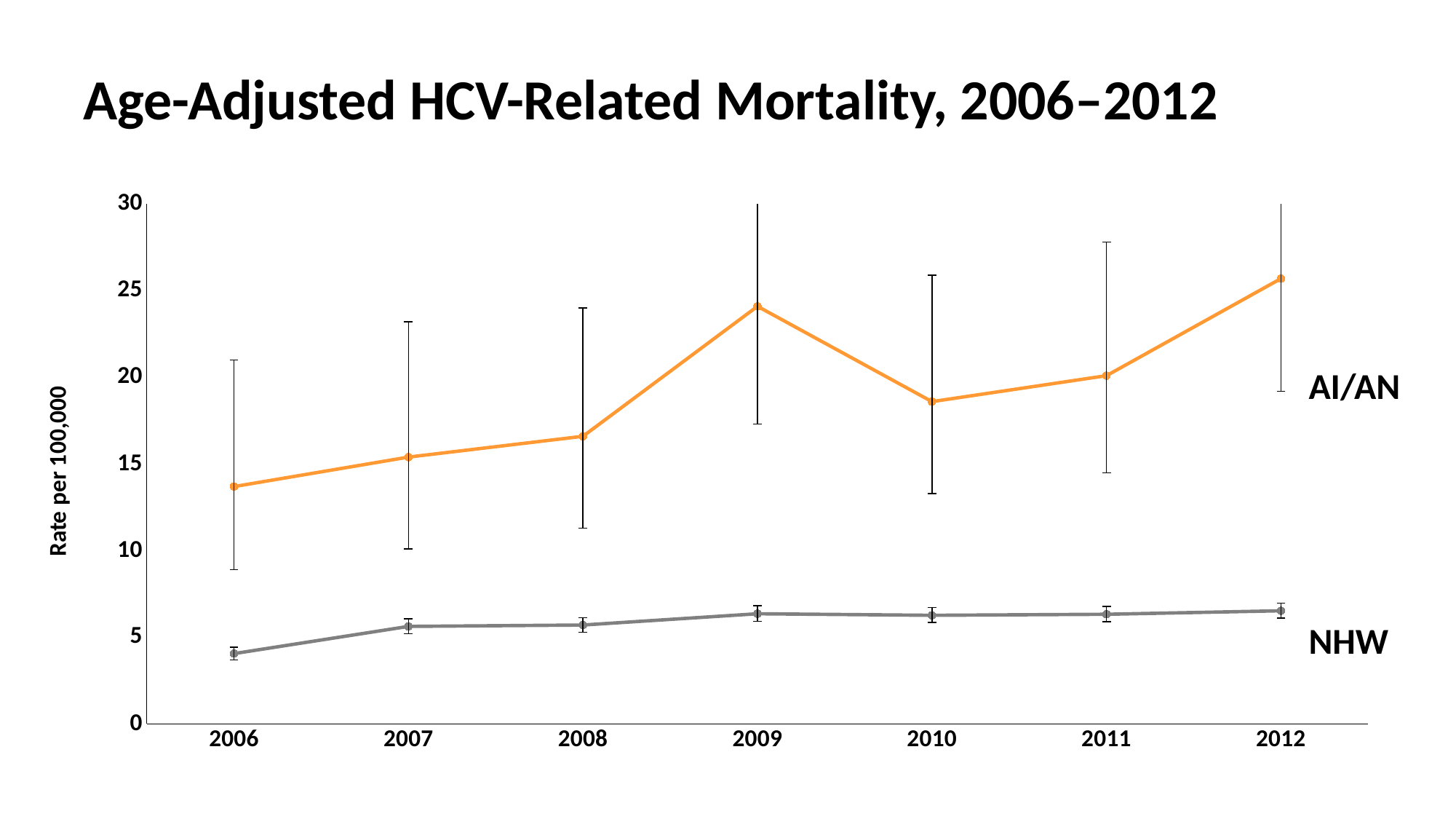
Is the AI/AN value for 2010 greater or less than 20? less In which year is the AI/AN rate highest? 2012 In which year is the AI/AN rate lowest? 2006 Which series has the higher rate in 2009, AI/AN or NHW? AI/AN Is the AI/AN value for 2006 greater or less than 15? less Is the NHW value for 2006 greater or less than 5? less How many years are plotted along the x axis? 7 In which year is the NHW rate lowest? 2006 What is the label on the y axis? Rate per 100,000 What kind of chart is shown on the slide? line chart How many series are plotted on the chart? 2